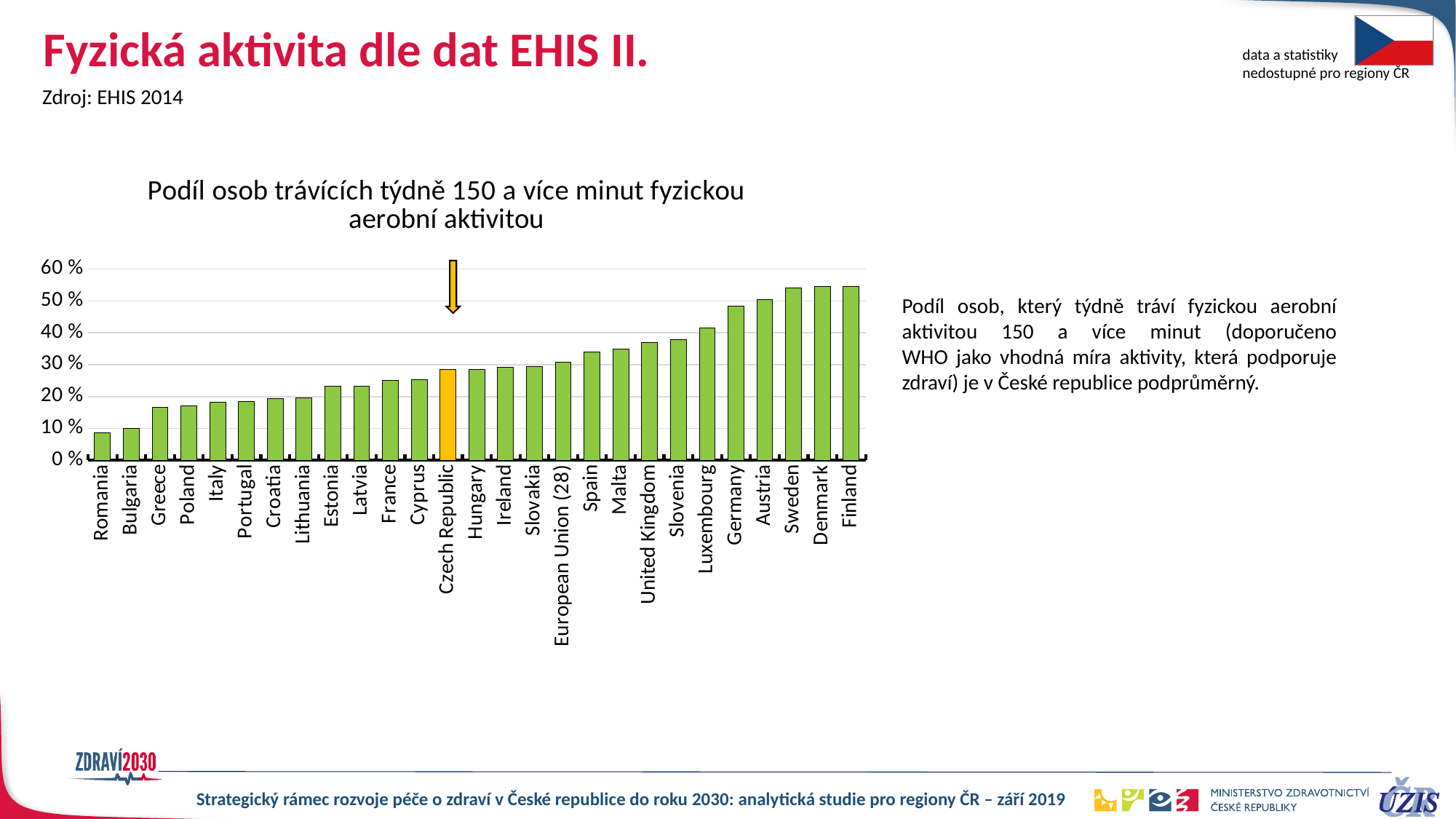
Do the values rise or fall moving from left to right along the x axis? rise Is the value for Romania greater or less than 10 %? less Is the value for Finland greater or less than 50 %? greater Which has a larger value, Czech Republic or Poland? Czech Republic Is the value for Czech Republic greater or less than 30 %? less Which has a larger value, Germany or Spain? Germany What kind of chart is shown on the slide? bar chart How many countries/categories are plotted on the x axis of the chart? 27 Which category has the lowest value in the chart? Romania Which category's bar is highlighted in a different colour (orange) from the others? Czech Republic